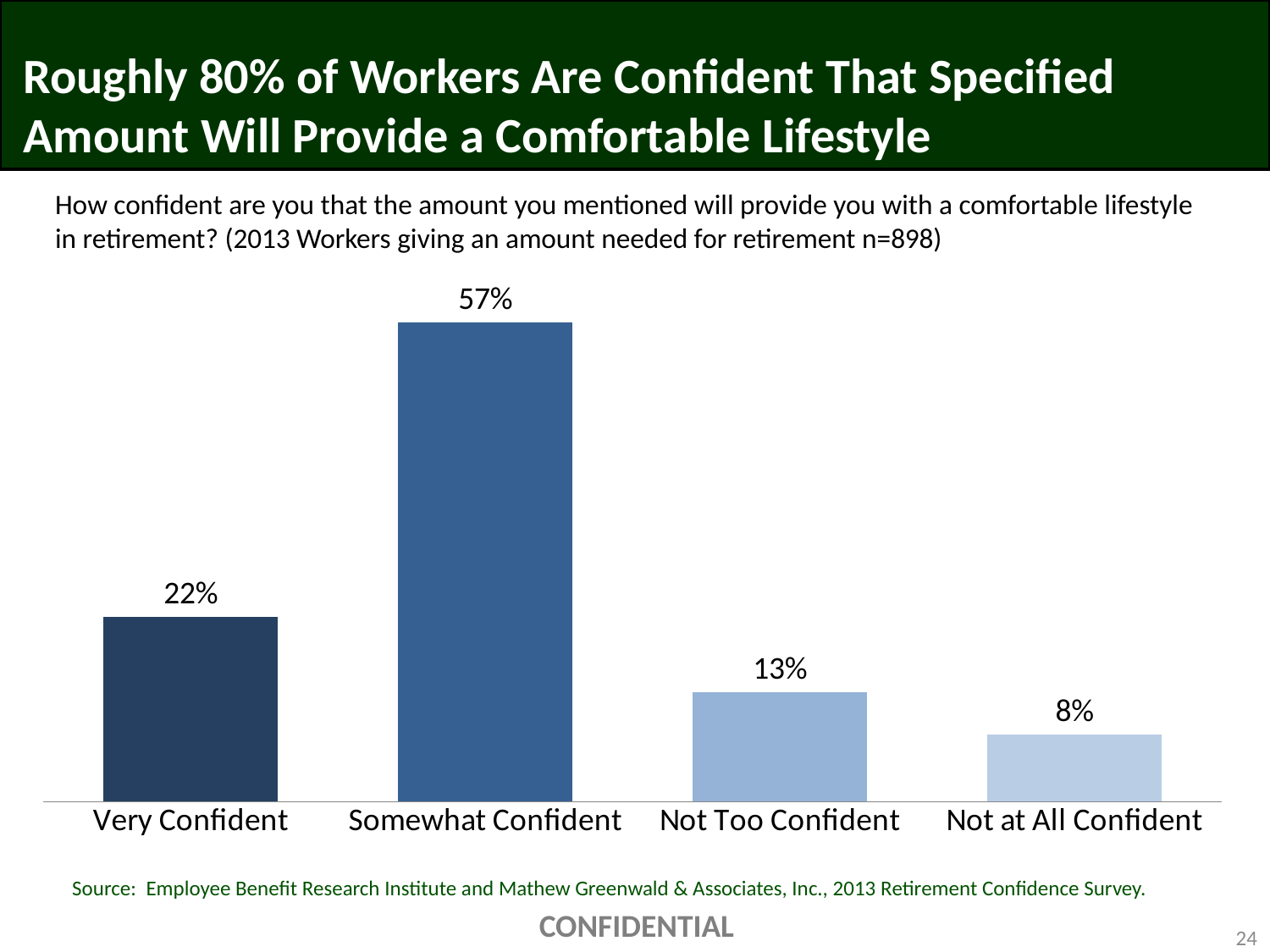
How many confidence categories are shown in the chart? 4 What type of chart is shown on the slide? Bar chart Which is larger, the percentage for Very Confident or for Not Too Confident? Very Confident What is the difference in percentage points between Not Too Confident and Not at All Confident? 5 What percentage of workers are Very Confident? 22% What percentage of workers are Not Too Confident? 13% What percentage of workers are Somewhat Confident? 57% What is the combined percentage of workers who are Very Confident or Somewhat Confident? 79% Which confidence level has the lowest percentage? Not at All Confident Which confidence level has the highest percentage? Somewhat Confident What is the difference in percentage points between Somewhat Confident and Very Confident? 35 What percentage of workers are Not at All Confident? 8%